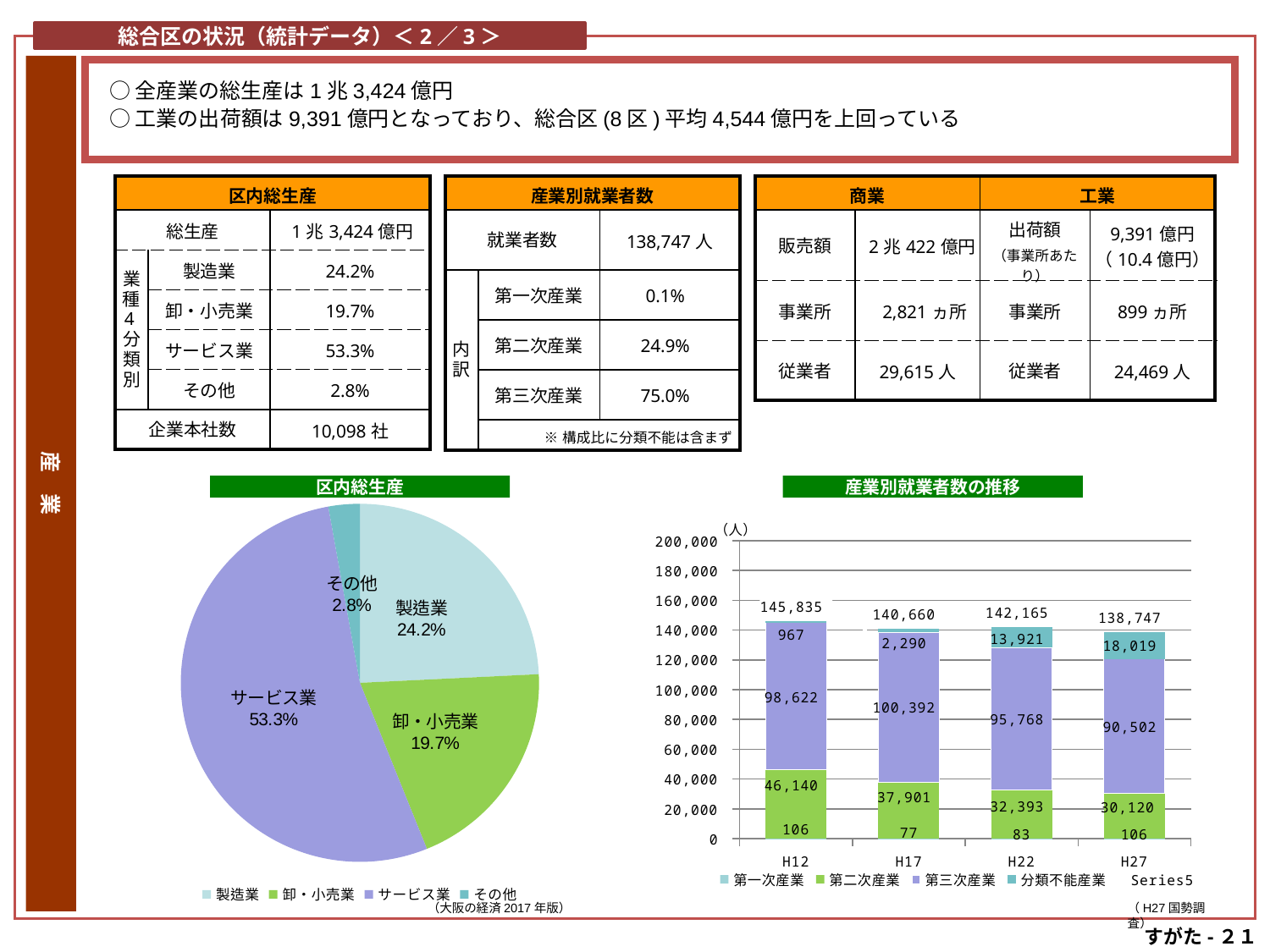
In the chart titled 産業別就業者数の推移, what is the total for H27? 138,747 In the pie chart titled 区内総生産, what is the difference between the shares of 製造業 and 卸・小売業? 4.5% In the chart titled 産業別就業者数の推移, what is the value for 第三次産業 in H17? 100,392 In the pie chart titled 区内総生産, which category has the smallest share? その他 In the chart titled 産業別就業者数の推移, does the value for 第二次産業 rise or fall from H12 to H27? Fall In the pie chart titled 区内総生産, what share does サービス業 have? 53.3% In the chart titled 産業別就業者数の推移, how many series does the legend list? 5 In the pie chart titled 区内総生産, how many categories are shown? 4 In the chart titled 産業別就業者数の推移, which year has the highest total? H12 In the chart titled 産業別就業者数の推移, what is the difference between the 分類不能産業 values for H27 and H22? 4,098 In the pie chart titled 区内総生産, what is the value for 卸・小売業? 19.7% What kind of chart is the chart titled 産業別就業者数の推移? Stacked bar chart